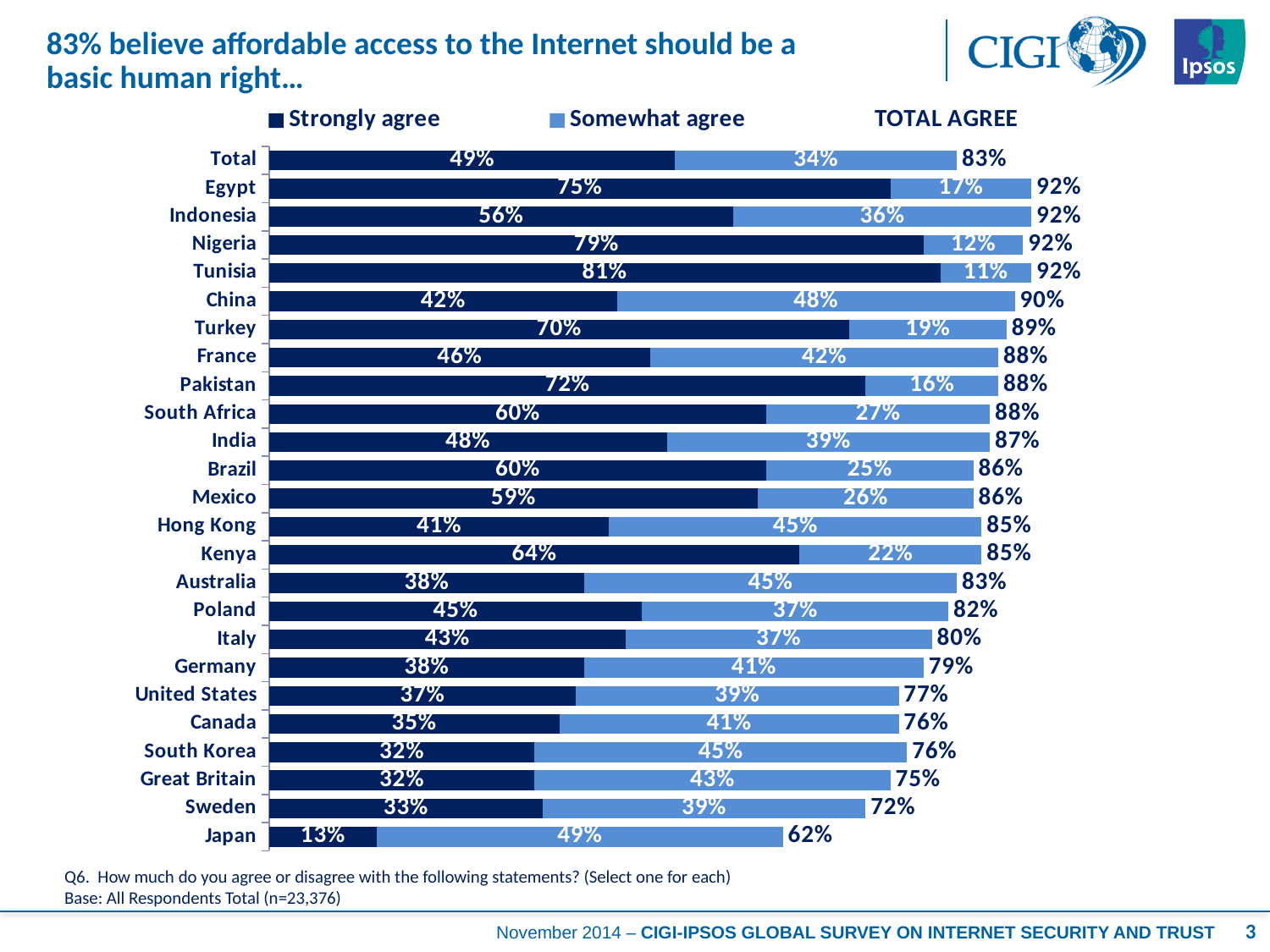
Which series is shown in the darker blue colour? Strongly agree What percentage of respondents in Egypt strongly agree? 75% Which country has the highest Strongly agree percentage? Tunisia What is the difference between the Strongly agree values for Nigeria and Canada? 44% What is the total of the stacked bar for Sweden? 72% What is the TOTAL AGREE value for Japan? 62% How many series does the legend list? 2 How many categories (rows) are shown in the chart, including Total? 25 What type of chart is shown on the slide? Bar chart What is the Somewhat agree value for China? 48% Which has a higher Somewhat agree value, France or Pakistan? France Which country has the lowest Strongly agree percentage? Japan